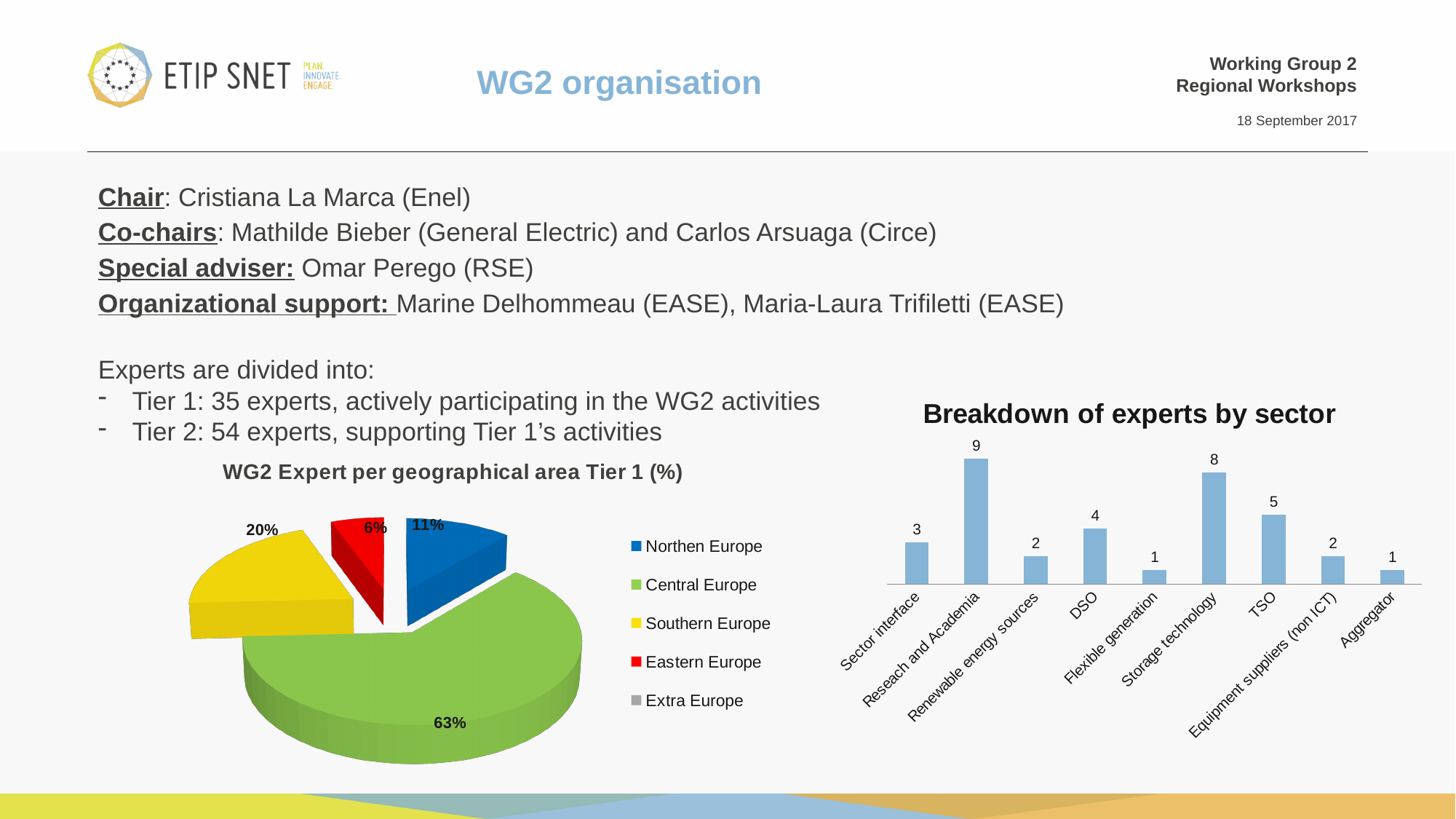
What kind of chart is 'WG2 Expert per geographical area Tier 1 (%)'? Pie chart In the 'Breakdown of experts by sector' chart, which sector has the highest number of experts? Research and Academia In the 'Breakdown of experts by sector' chart, what is the value for Storage technology? 8 How many entries does the legend of the 'WG2 Expert per geographical area Tier 1 (%)' chart list? 5 What kind of chart is 'Breakdown of experts by sector'? Bar chart In the 'Breakdown of experts by sector' chart, how many experts are in Research and Academia? 9 In the 'WG2 Expert per geographical area Tier 1 (%)' chart, which region has the largest share? Central Europe In the 'Breakdown of experts by sector' chart, which is larger: Sector interface or Renewable energy sources? Sector interface In the 'WG2 Expert per geographical area Tier 1 (%)' chart, what share is Central Europe? 63% In the 'Breakdown of experts by sector' chart, what is the difference between the values for TSO and DSO? 1 In the 'WG2 Expert per geographical area Tier 1 (%)' chart, what share is Southern Europe? 20% How many sectors are shown in the 'Breakdown of experts by sector' chart? 9